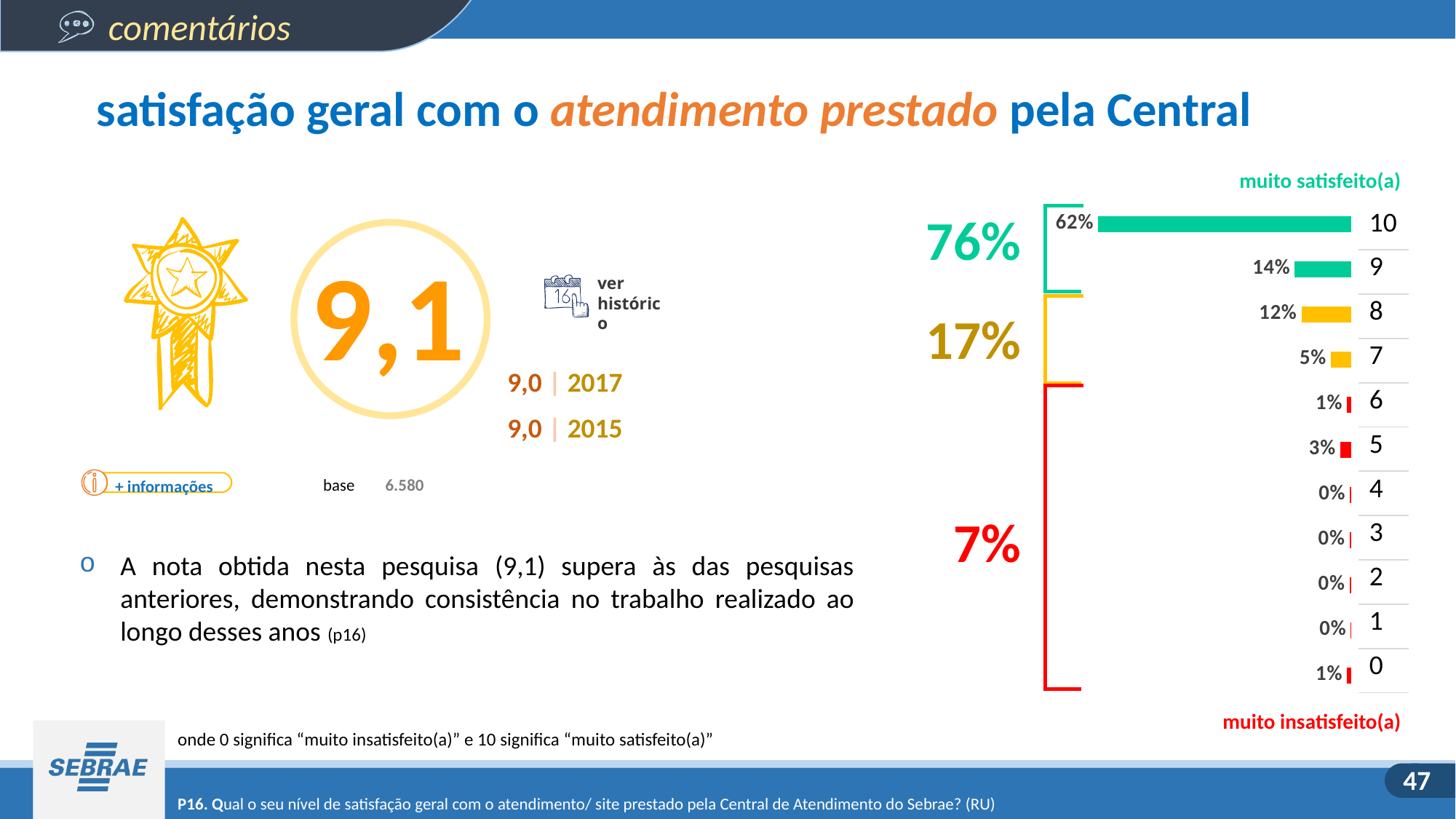
Which has a larger percentage, score 9 or score 8? score 9 What kind of chart is used to show the distribution of scores? bar chart What is the combined percentage shown for scores 9 and 10 (the green bracket)? 76% Which has a larger percentage, score 5 or score 6? score 5 What percentage of respondents gave a score of 5? 3% How many score categories are shown in the bar chart? 11 What percentage of respondents gave a score of 10? 62% Which score has the highest percentage of respondents? 10 What is the combined percentage shown for scores 0 to 6 (the red bracket)? 7% What is the difference in percentage points between the score 10 bar and the score 9 bar? 48 What percentage of respondents gave a score of 8? 12% What is the difference in percentage points between the score 8 bar and the score 7 bar? 7